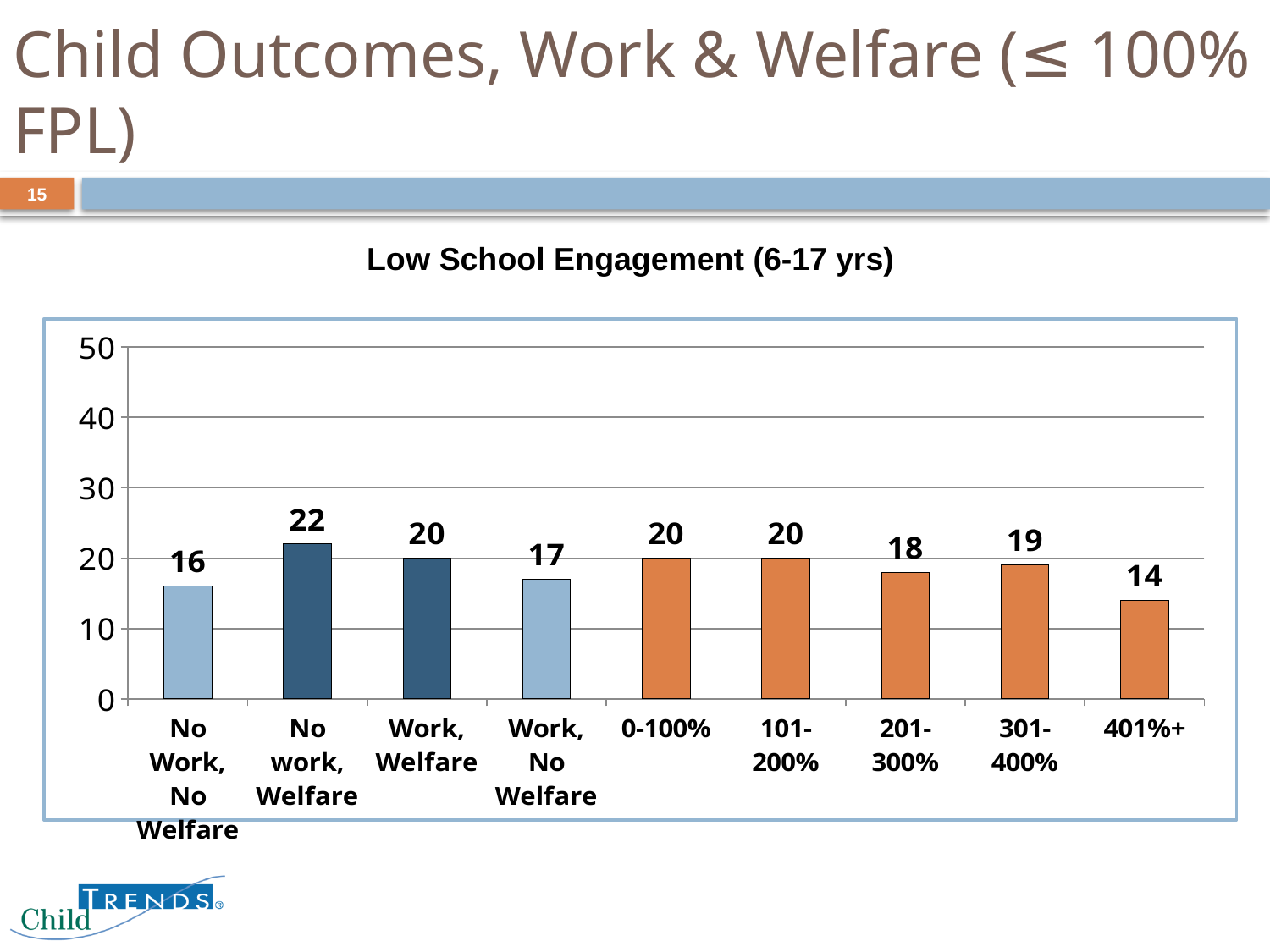
What is the value for the 'Work, No Welfare' category? 17 Which category has the lowest value? 401%+ What is the difference between the values for 'No work, Welfare' and 'No Work, No Welfare'? 6 What is the value for the 'No work, Welfare' category? 22 What is the difference between the values for '0-100%' and '401%+'? 6 Is the value for '0-100%' greater or less than 30? less Which category has the highest value? No work, Welfare Which is larger, the value for '301-400%' or the value for '201-300%'? 301-400% How many categories are shown on the x axis? 9 What is the title of the chart? Low School Engagement (6-17 yrs) What is the value for the '401%+' category? 14 What kind of chart is shown on the slide? bar chart